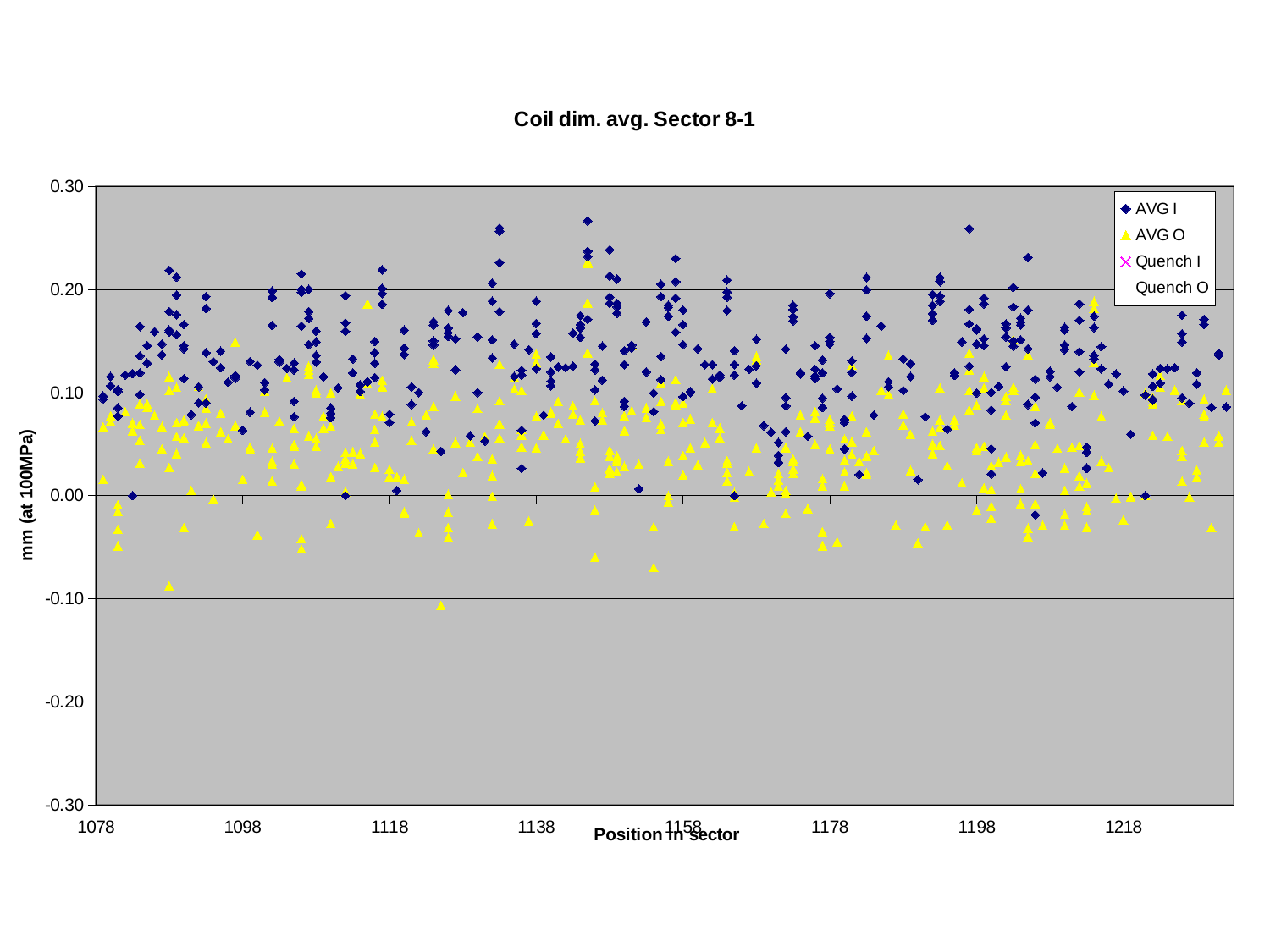
What is the label of the horizontal axis? Position in sector Which series generally has higher values, AVG I or AVG O? AVG I What kind of chart is shown on the slide? scatter chart What is the first tick value on the horizontal axis? 1078 What are the series names listed in the legend? AVG I, AVG O, Quench I, Quench O How many series does the legend list? 4 What is the highest value shown on the vertical axis? 0.30 Are all the AVG I points less than 0.30? Yes What is the label of the vertical axis? mm (at 100MPa) What is the lowest value shown on the vertical axis? -0.30 Are any plotted points below -0.20 on the vertical axis? No What is the title of the chart? Coil dim. avg. Sector 8-1